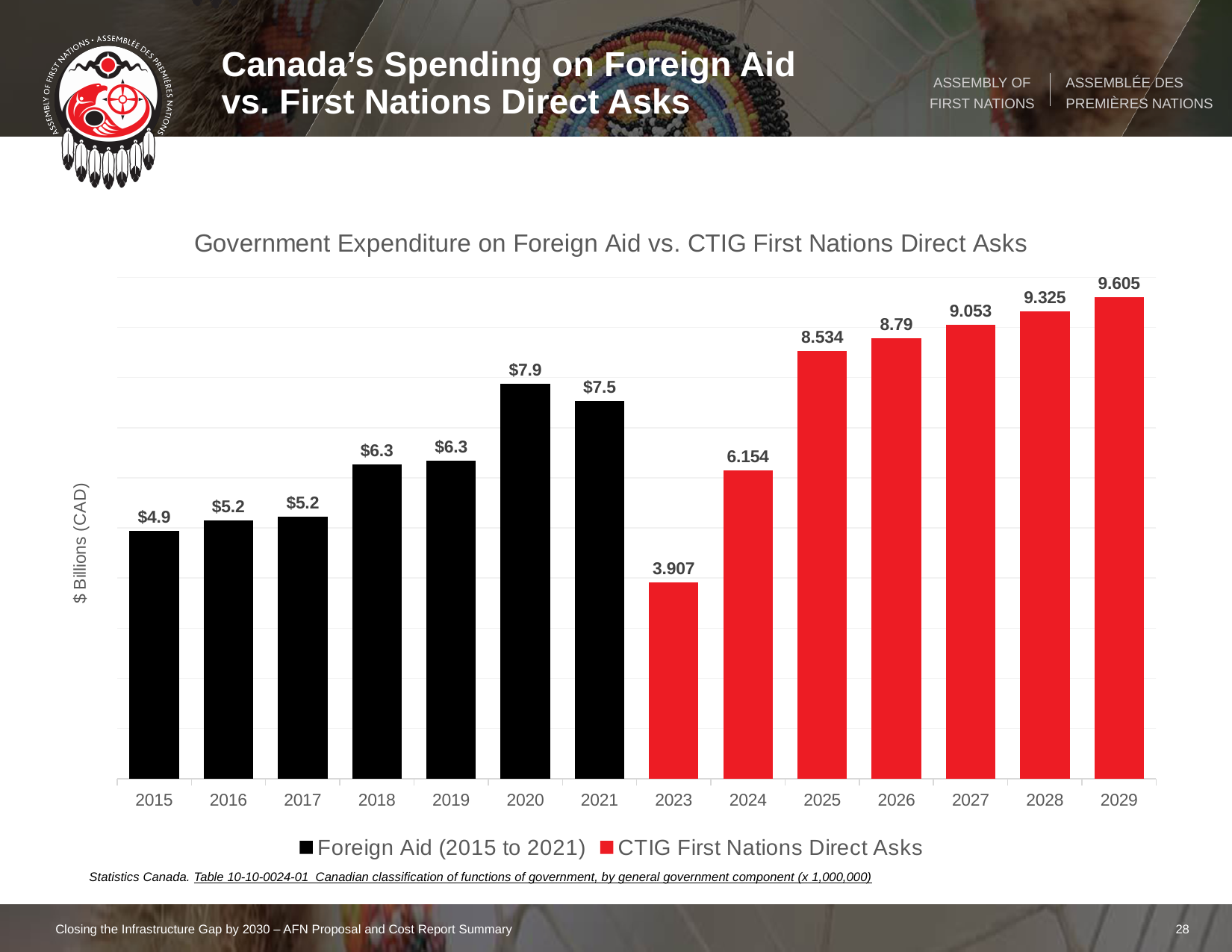
Which is larger, the value for 2021 or the value for 2024? 2021 Which year has the lowest value on the chart? 2023 What is the value shown for 2029? 9.605 How many years are shown on the x axis? 14 What is the Foreign Aid value for 2020? $7.9 What type of chart is shown on the slide? Bar chart What is the CTIG First Nations Direct Asks value for 2023? 3.907 Which year has the highest value on the chart? 2029 How many series does the legend list? 2 Which year has the highest Foreign Aid value? 2020 Do the CTIG First Nations Direct Asks values rise or fall from 2023 to 2029? Rise What is the difference between the Foreign Aid values for 2020 and 2021? $0.4